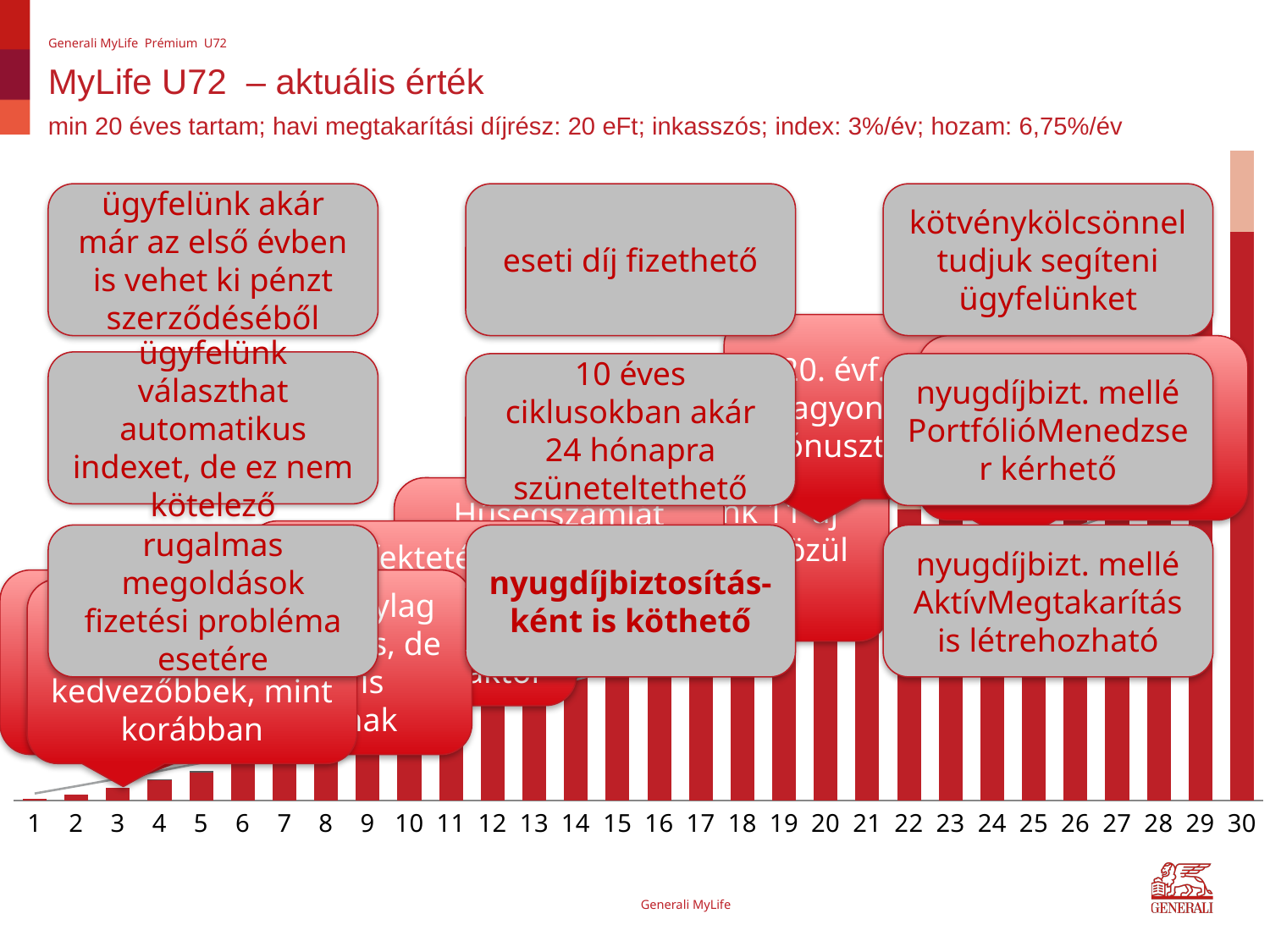
Which category has the shortest bar in the chart? 1 Which bar is taller, the one for category 29 or the one for category 30? 30 Which bar is taller, the one for category 5 or the one for category 25? 25 How many categories are shown on the x axis of the chart? 30 What colour are the bars in the chart? red What is the first category label on the x axis of the chart? 1 Which category has the tallest bar in the chart? 30 Which bar is taller, the one for category 2 or the one for category 8? 8 What kind of chart is shown on the slide? bar chart Do the bar values rise or fall as the x axis goes from 1 to 30? rise